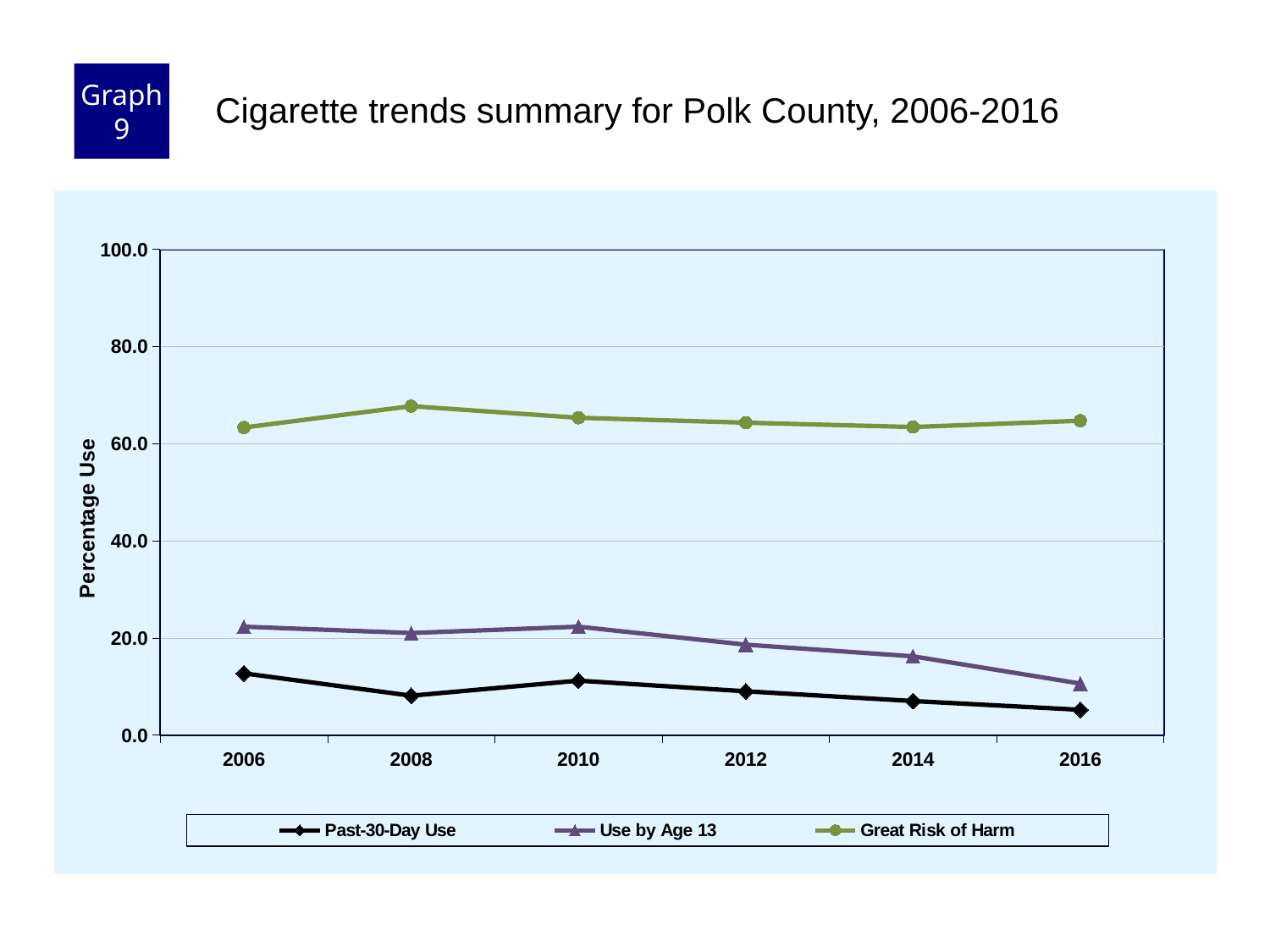
Is the value for Past-30-Day Use in 2016 greater or less than 20.0? less In 2010, which series has the higher value: Great Risk of Harm or Past-30-Day Use? Great Risk of Harm In 2012, which series has the higher value: Use by Age 13 or Past-30-Day Use? Use by Age 13 Is the value for Use by Age 13 in 2016 greater or less than 20.0? less Is the value for Great Risk of Harm in 2014 greater or less than 80.0? less In which year is the Use by Age 13 value lowest? 2016 What kind of chart is shown on the slide? Line chart How many years are plotted along the x axis? 6 What is the label on the y axis? Percentage Use How many series does the legend list? 3 Does the Use by Age 13 series rise or fall from 2010 to 2016? Fall